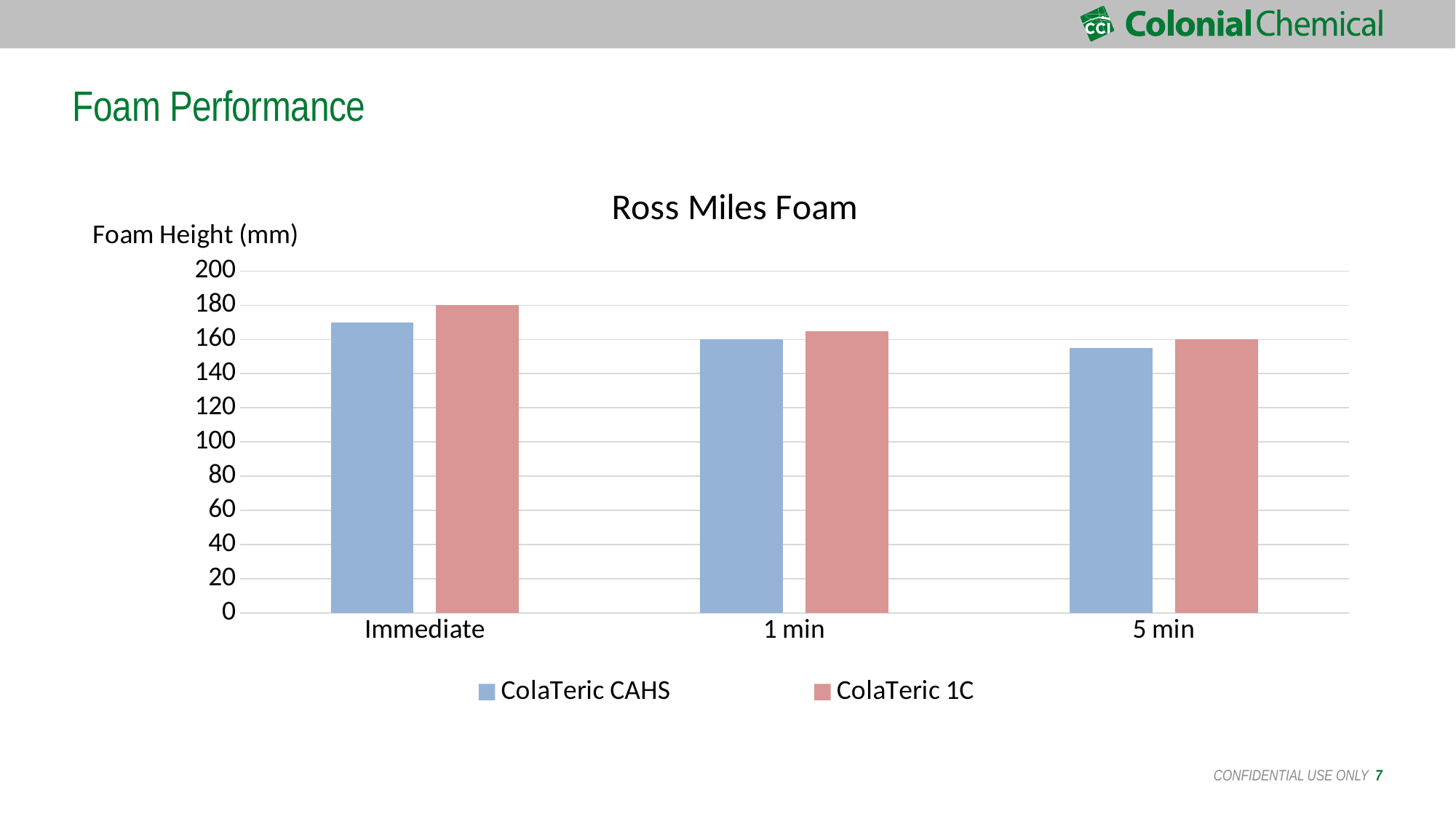
Is the value for ColaTeric CAHS at 5 min greater or less than 160? less What type of chart is shown on the slide? bar chart At Immediate, which series has the higher foam height, ColaTeric CAHS or ColaTeric 1C? ColaTeric 1C What is the foam height for ColaTeric 1C at 5 min? 160 What is the foam height for ColaTeric 1C at Immediate? 180 How many series does the legend list? 2 What is the foam height for ColaTeric CAHS at 1 min? 160 Is the value for ColaTeric CAHS at Immediate greater or less than 180? less How many categories are shown on the x axis? 3 Is the value for ColaTeric 1C at 1 min greater or less than 160? greater Do the ColaTeric CAHS values rise or fall from Immediate to 5 min? fall What is the title of the chart? Ross Miles Foam